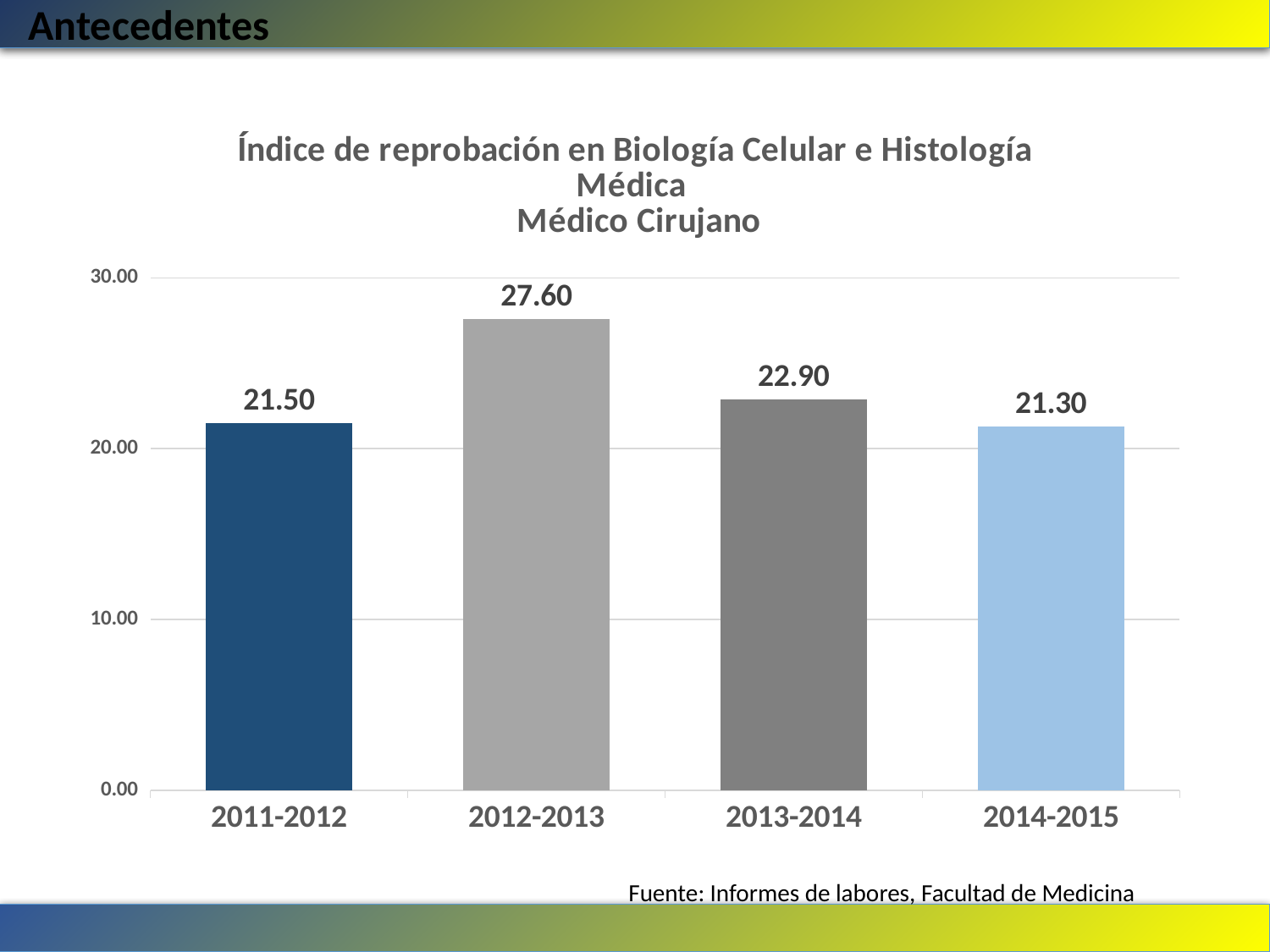
What is the value for 2011-2012? 21.50 Does the value rise or fall from 2012-2013 to 2014-2015? fall What is the difference between the values for 2012-2013 and 2013-2014? 4.70 Which is larger, the value for 2013-2014 or the value for 2011-2012? 2013-2014 What is the value for 2012-2013? 27.60 What is the source cited below the chart? Informes de labores, Facultad de Medicina Which period has the lowest value? 2014-2015 Is the value for 2012-2013 greater or less than 20.00? greater What is the value for 2014-2015? 21.30 How many periods are shown on the x axis? 4 What kind of chart is shown on the slide? bar chart Which period has the highest value? 2012-2013